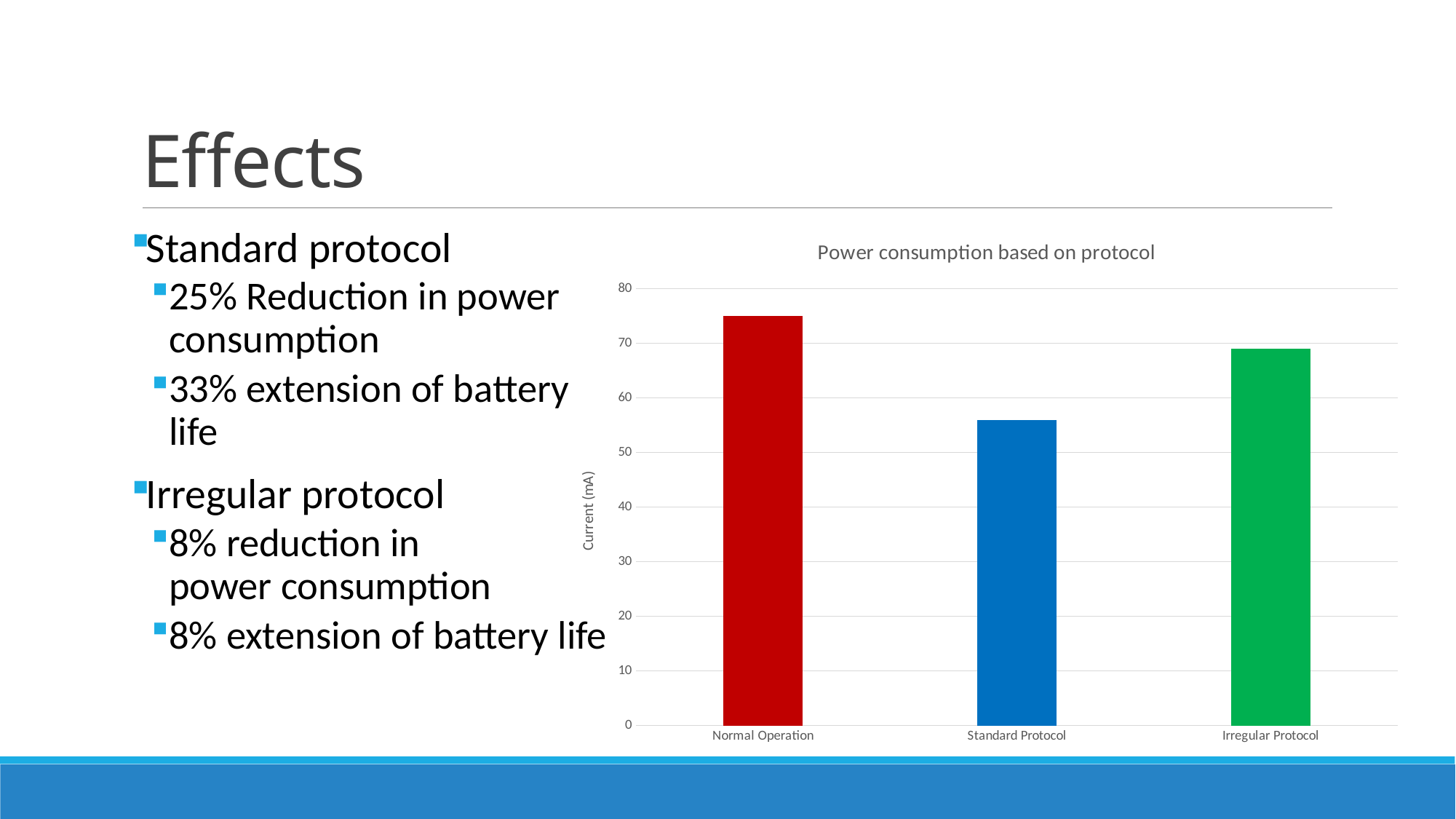
What type of chart is shown on the slide? bar chart What is the label of the vertical axis of the chart? Current (mA) Which category has the lowest current in the chart? Standard Protocol How many bars are plotted in the chart? 3 Is the value for Irregular Protocol greater or less than 60? greater Is the value for Standard Protocol greater or less than 50? greater Is the value for Standard Protocol greater or less than 60? less What is the title of the chart? Power consumption based on protocol Which has a higher current, Standard Protocol or Irregular Protocol? Irregular Protocol Which has a higher current, Normal Operation or Irregular Protocol? Normal Operation Which category has the highest current in the chart? Normal Operation